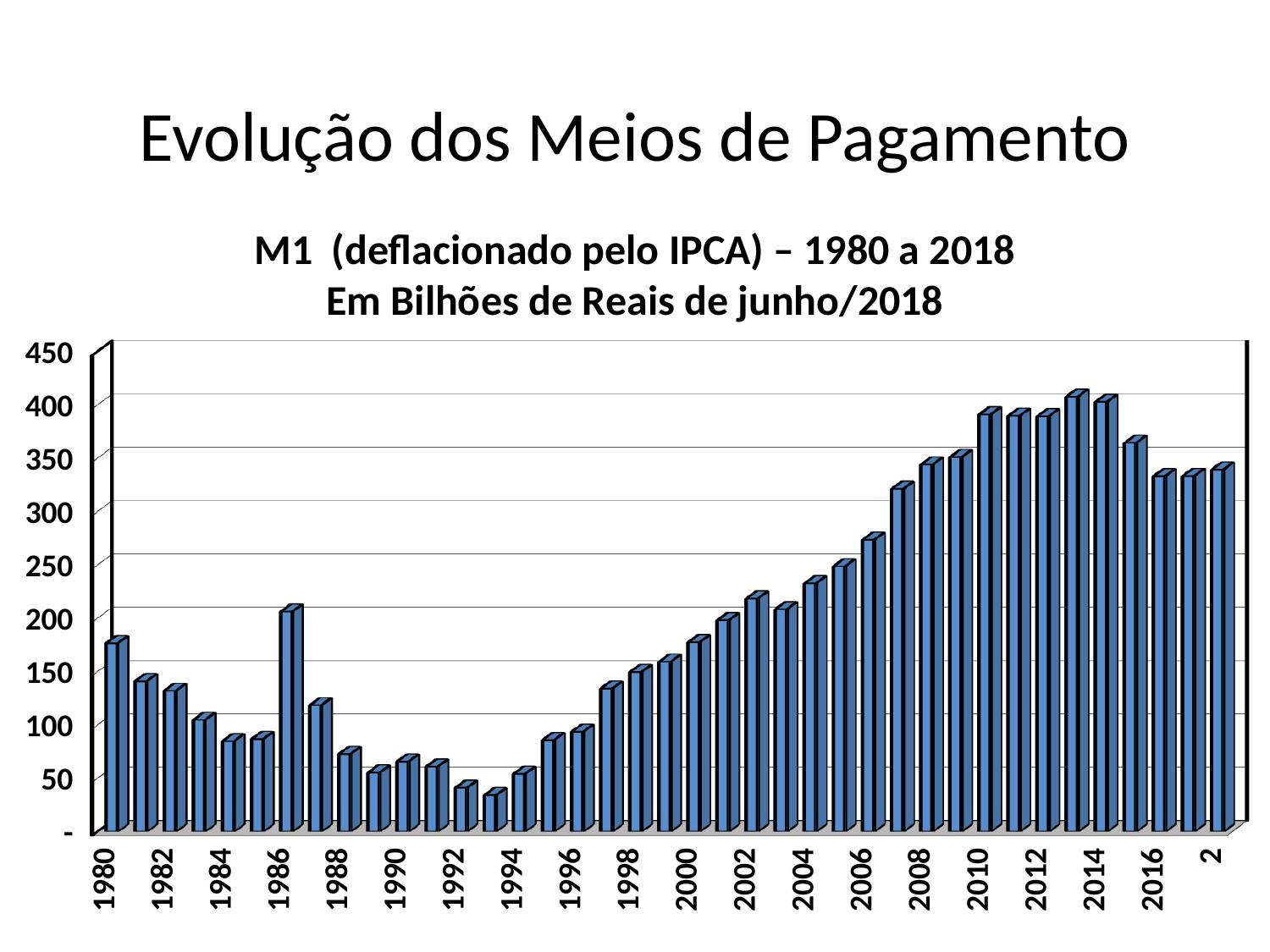
How many bars (years) are plotted in the chart? 39 What is the title of the chart? M1 (deflacionado pelo IPCA) – 1980 a 2018 Em Bilhões de Reais de junho/2018 Is the value for 2016 greater or less than 350? less Is the value for 2010 greater or less than 350? greater Is the value for 2007 greater or less than 300? greater Which year has the lowest value in the chart? 1993 Which year has the larger value, 2006 or 2008? 2008 What kind of chart is shown on the slide? bar chart Do the values generally rise or fall from 1994 to 2013? rise Which year has the larger value, 1980 or 1986? 1986